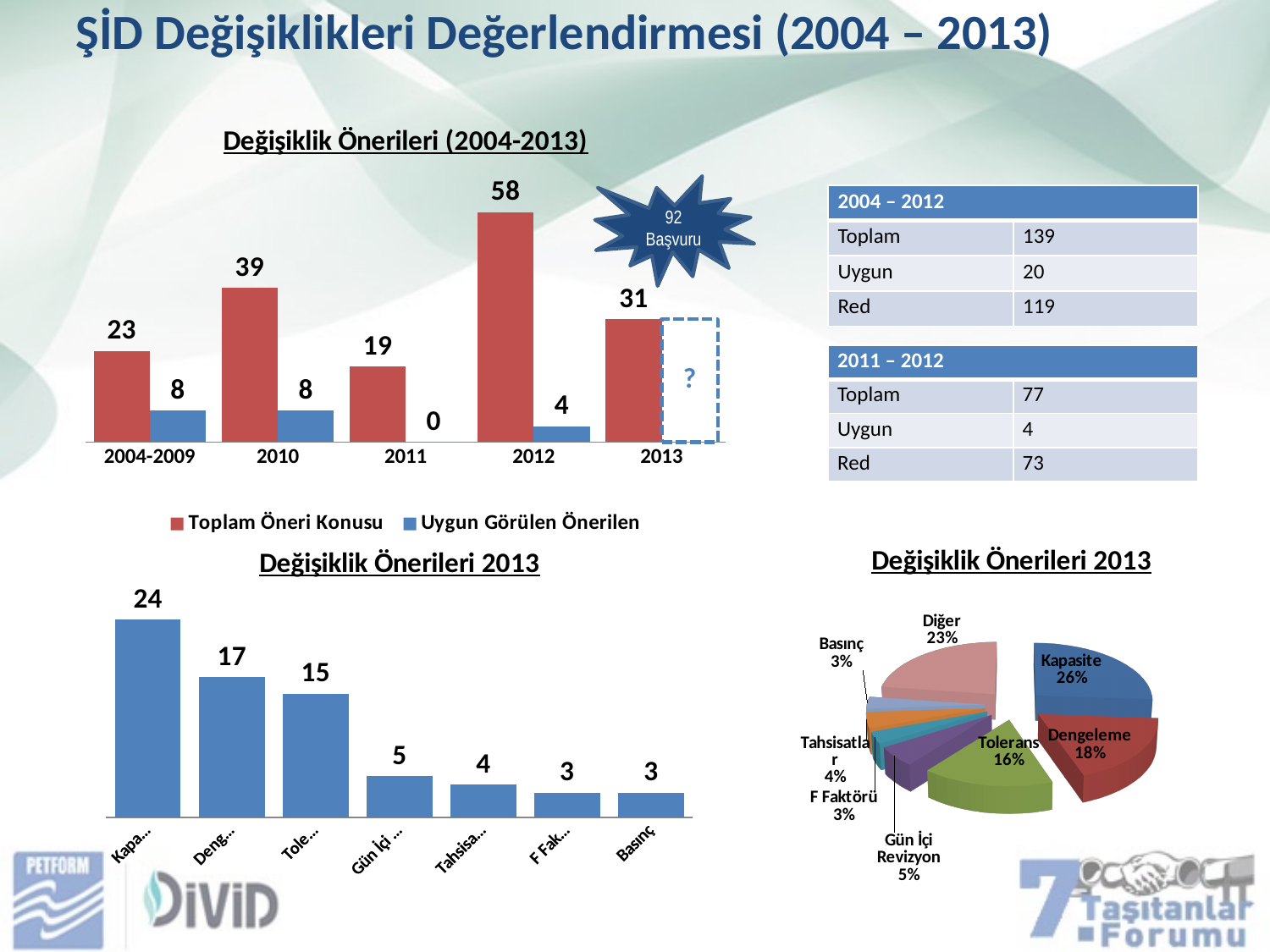
In the bottom-left bar chart titled 'Değişiklik Önerileri 2013', how many bars are plotted? 7 In the chart titled 'Değişiklik Önerileri (2004-2013)', which category has the highest Toplam Öneri Konusu value? 2012 What kind of chart is the bottom-left chart titled 'Değişiklik Önerileri 2013'? bar chart In the bottom-left bar chart titled 'Değişiklik Önerileri 2013', what is the value for Basınç? 3 In the chart titled 'Değişiklik Önerileri (2004-2013)', what is the value of Toplam Öneri Konusu for 2012? 58 In the chart titled 'Değişiklik Önerileri (2004-2013)', is the Toplam Öneri Konusu value for 2013 larger or smaller than for 2010? smaller In the chart titled 'Değişiklik Önerileri (2004-2013)', what is the difference between Toplam Öneri Konusu and Uygun Görülen Önerilen for 2010? 31 In the bottom-left bar chart titled 'Değişiklik Önerileri 2013', what is the value of the first (leftmost) bar? 24 In the pie chart titled 'Değişiklik Önerileri 2013', what share does Kapasite have? 26% In the pie chart titled 'Değişiklik Önerileri 2013', which slice is the largest? Kapasite In the chart titled 'Değişiklik Önerileri (2004-2013)', how many series does the legend list? 2 In the chart titled 'Değişiklik Önerileri (2004-2013)', what is the value of Uygun Görülen Önerilen for 2011? 0